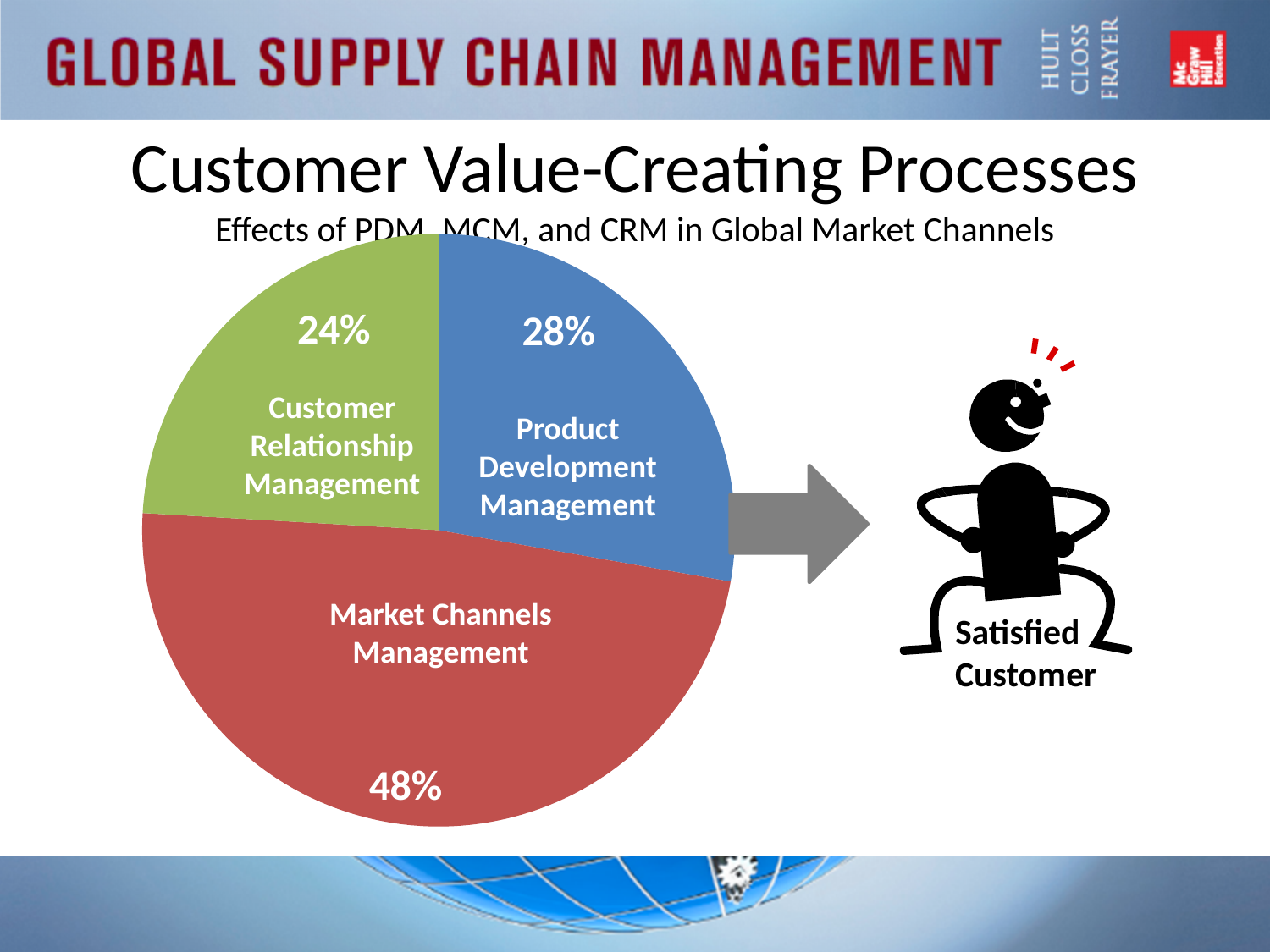
Which is larger, the share for Product Development Management or the share for Customer Relationship Management? Product Development Management Which slice of the pie is the largest? Market Channels Management What share of the pie does Market Channels Management have? 48% What share of the pie does Product Development Management have? 28% What kind of chart is shown on the slide? pie chart What is the difference in percentage points between Market Channels Management and Product Development Management? 20 What is the difference in percentage points between Product Development Management and Customer Relationship Management? 4 How many slices does the pie chart have? 3 What share of the pie does Customer Relationship Management have? 24% What colour is the Market Channels Management slice? red What colour is the Customer Relationship Management slice? green Which slice of the pie is the smallest? Customer Relationship Management